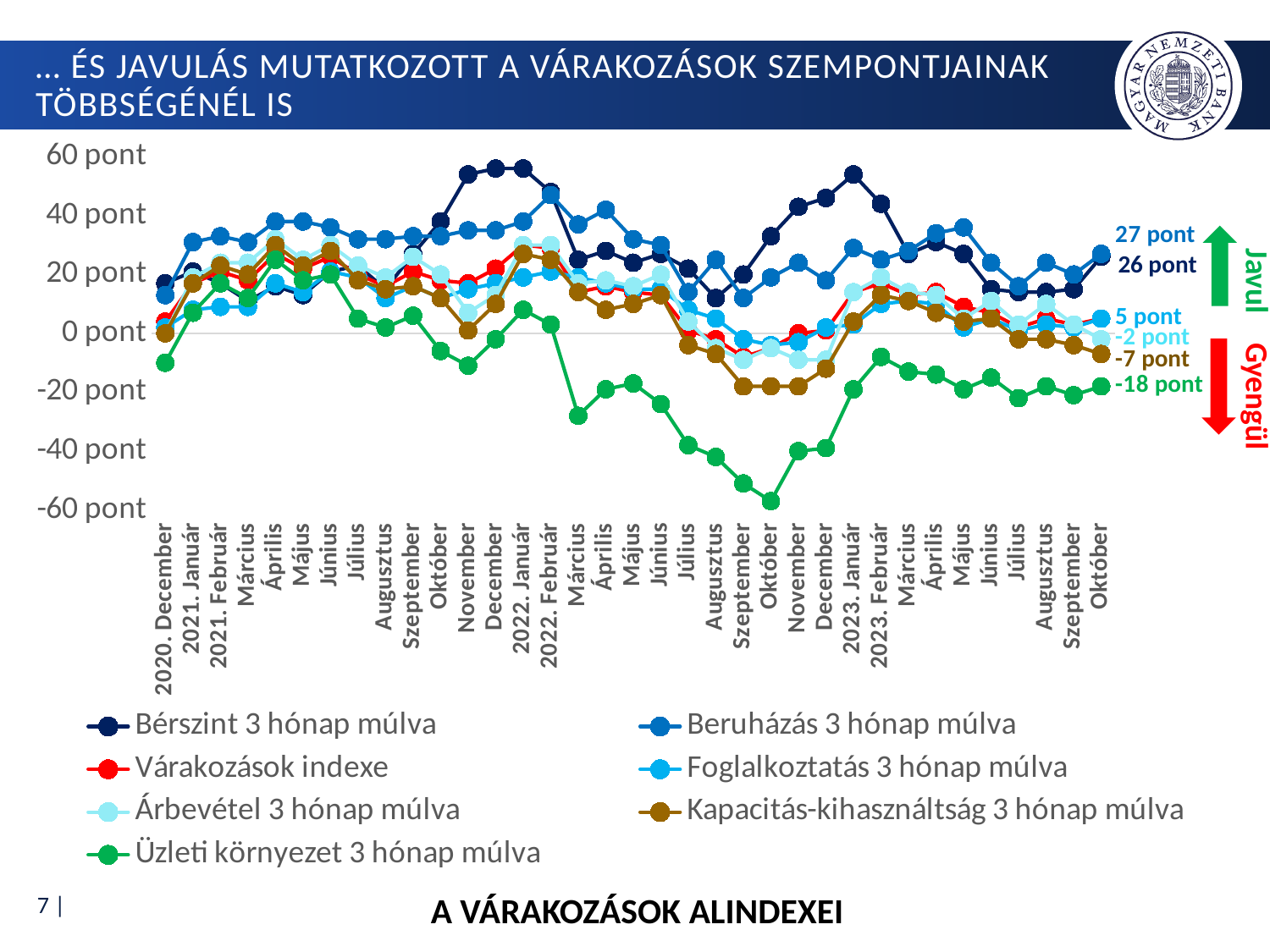
How many series does the legend list? 7 What is the value of Üzleti környezet 3 hónap múlva at the end of the series (2023 Október)? -18 pont What kind of chart is shown on the slide? line chart What is the value of Bérszint 3 hónap múlva at the end of the series (2023 Október)? 26 pont What is the title of the chart shown at the bottom of the slide? A VÁRAKOZÁSOK ALINDEXEI What is the value of Kapacitás-kihasználtság 3 hónap múlva at the end of the series (2023 Október)? -7 pont What is the value of Beruházás 3 hónap múlva at the end of the series (2023 Október)? 27 pont What is the difference between the end values of Foglalkoztatás 3 hónap múlva (5 pont) and Árbevétel 3 hónap múlva (-2 pont)? 7 pont Which series has the lowest value at the end of the series (2023 Október)? Üzleti környezet 3 hónap múlva Which series has the highest value at the end of the series (2023 Október)? Beruházás 3 hónap múlva Is the value of Bérszint 3 hónap múlva in 2022 December greater or less than 40 pont? greater Is the value of Üzleti környezet 3 hónap múlva in 2022 Október greater or less than -40 pont? less